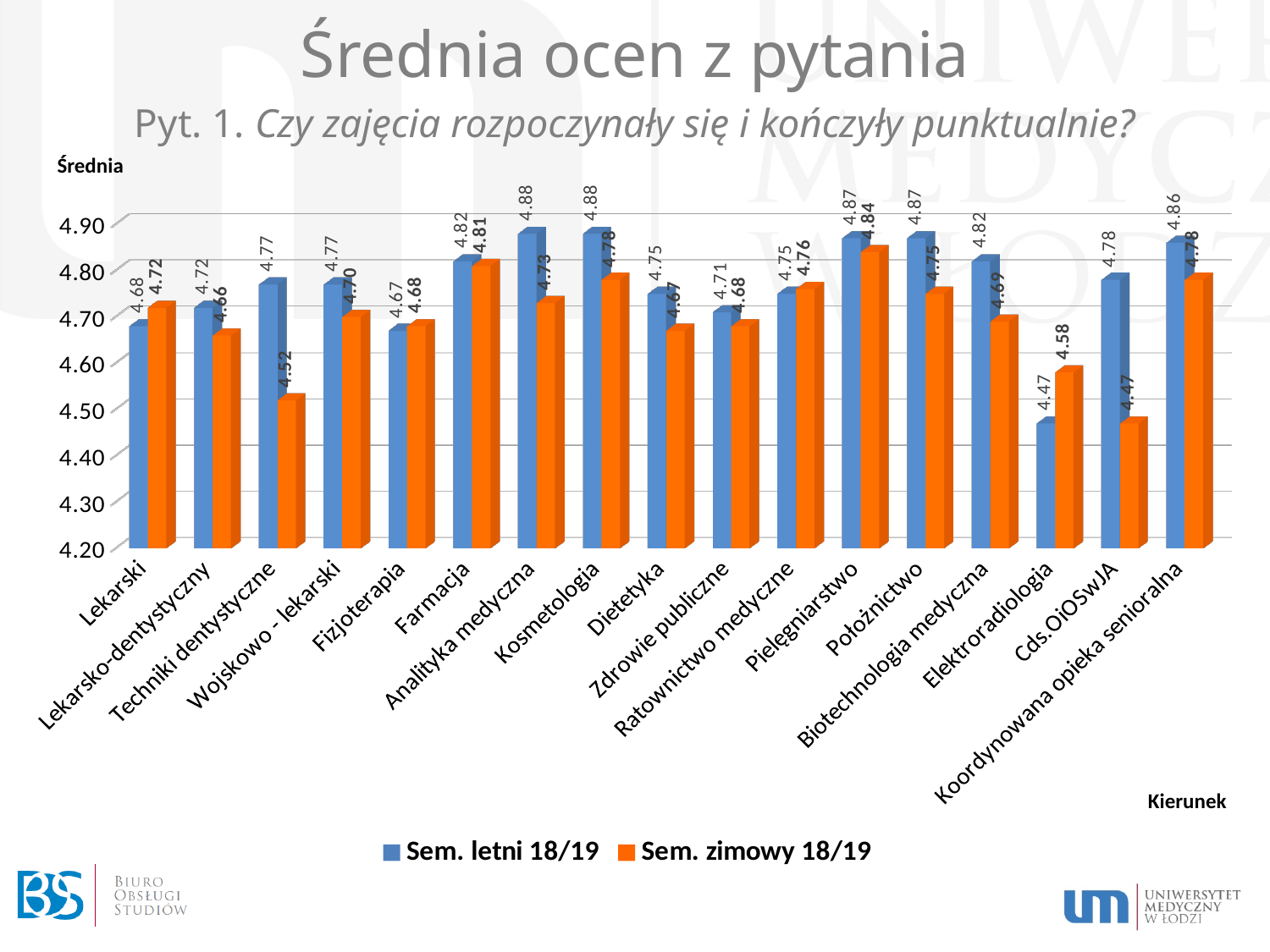
What is the difference between the Sem. letni 18/19 and Sem. zimowy 18/19 values for Techniki dentystyczne? 0.25 What is the difference between the Sem. zimowy 18/19 and Sem. letni 18/19 values for Elektroradiologia? 0.11 Which category has the lowest Sem. letni 18/19 value? Elektroradiologia Which category has the lowest Sem. zimowy 18/19 value? Cds.OiOSwJA What is the Sem. letni 18/19 value for Techniki dentystyczne? 4.77 Which category has the highest Sem. zimowy 18/19 value? Pielęgniarstwo For Lekarski, which is larger: the Sem. letni 18/19 value or the Sem. zimowy 18/19 value? Sem. zimowy 18/19 What kind of chart is shown on the slide? Bar chart What is the Sem. zimowy 18/19 value for Pielęgniarstwo? 4.84 How many series does the legend list? 2 What is the Sem. zimowy 18/19 value for Techniki dentystyczne? 4.52 How many categories (kierunki) are shown on the x axis? 17